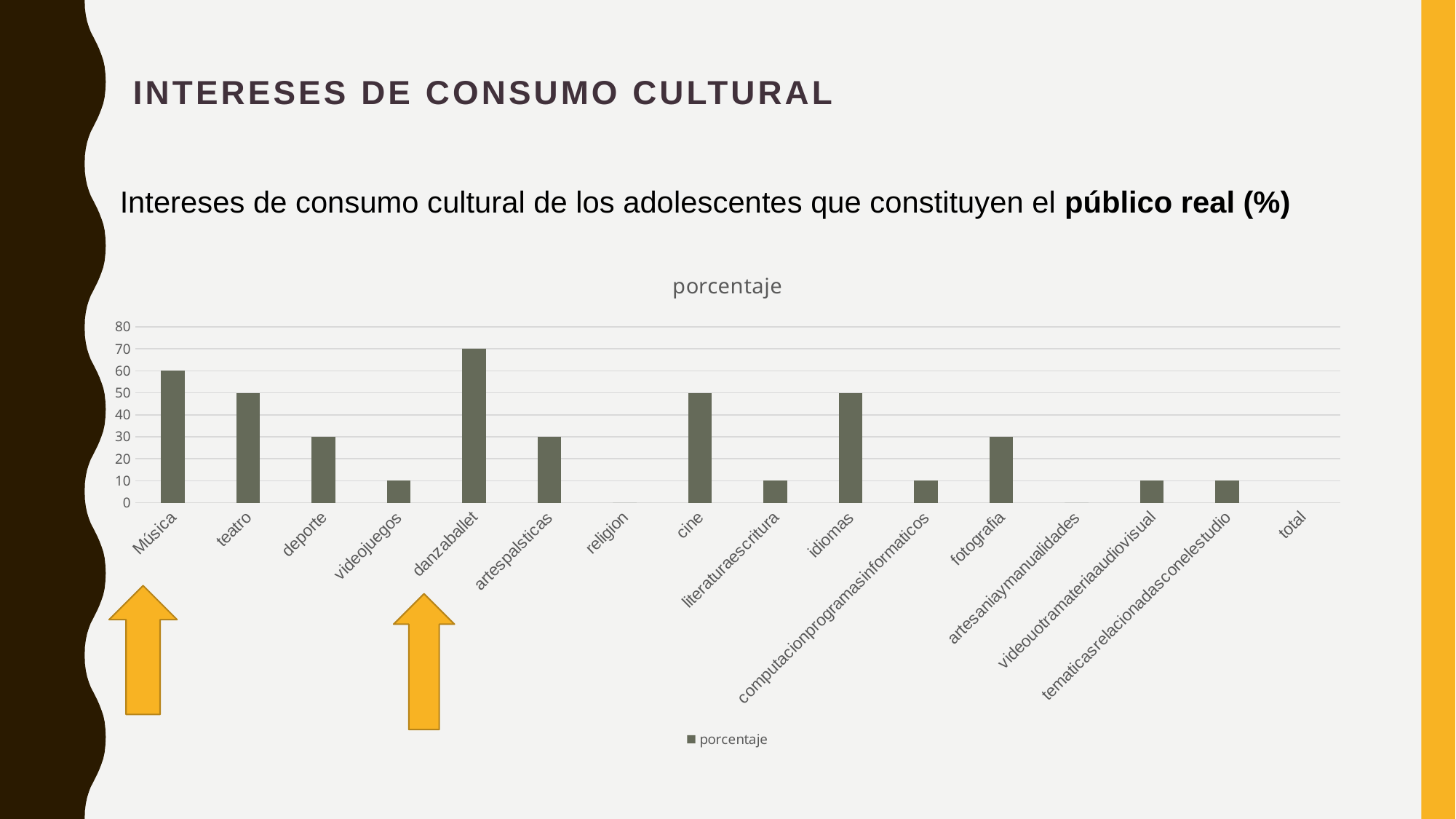
Is the value for videojuegos greater or less than 20? less Which is larger, the value for idiomas or the value for fotografia? idiomas Which category has the highest value in the chart? danzaballet How many categories are shown on the x axis of the chart? 16 How many series does the legend list? 1 What is the value for Música? 60 What is the title of the chart? porcentaje What type of chart is shown on the slide? bar chart Is the value for cine greater or less than 40? greater What is the value for danzaballet? 70 What is the difference between the values for danzaballet and Música? 10 Which is larger, the value for Música or the value for teatro? Música